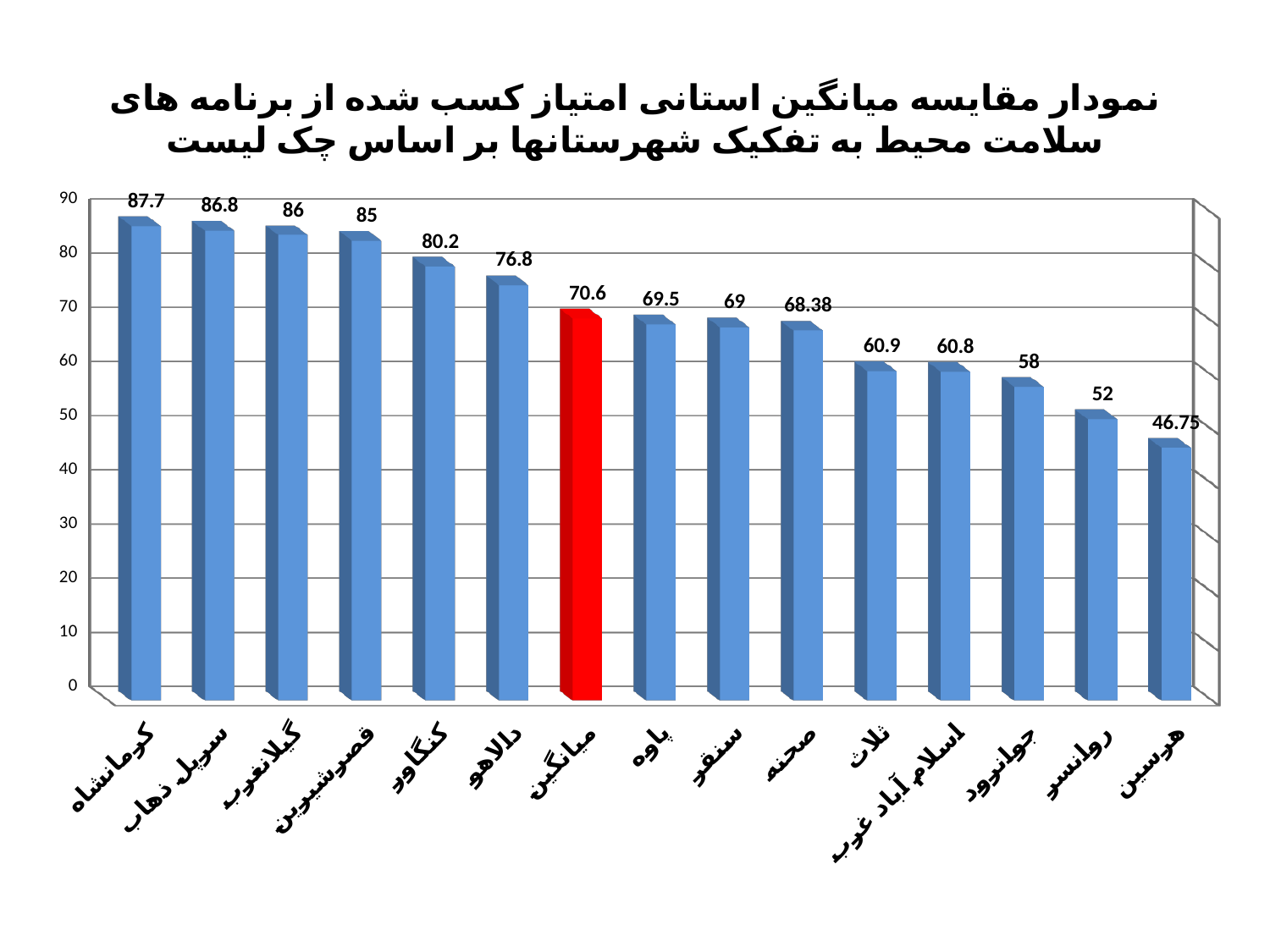
Which is larger, the value for پاوه or the value for جوانرود? پاوه What kind of chart is shown on the slide? Bar chart Which bar is coloured red instead of blue? میانگین Which category has the highest value? کرمانشاه What is the value of the red bar labelled میانگین? 70.6 Which category has the lowest value? هرسین What is the value for کرمانشاه? 87.7 What is the value for صحنه? 68.38 What is the value for هرسین? 46.75 What is the difference between the values for کنگاور and دالاهو? 3.4 How many bars are shown in the chart? 15 What is the difference between the values for کرمانشاه and هرسین? 40.95